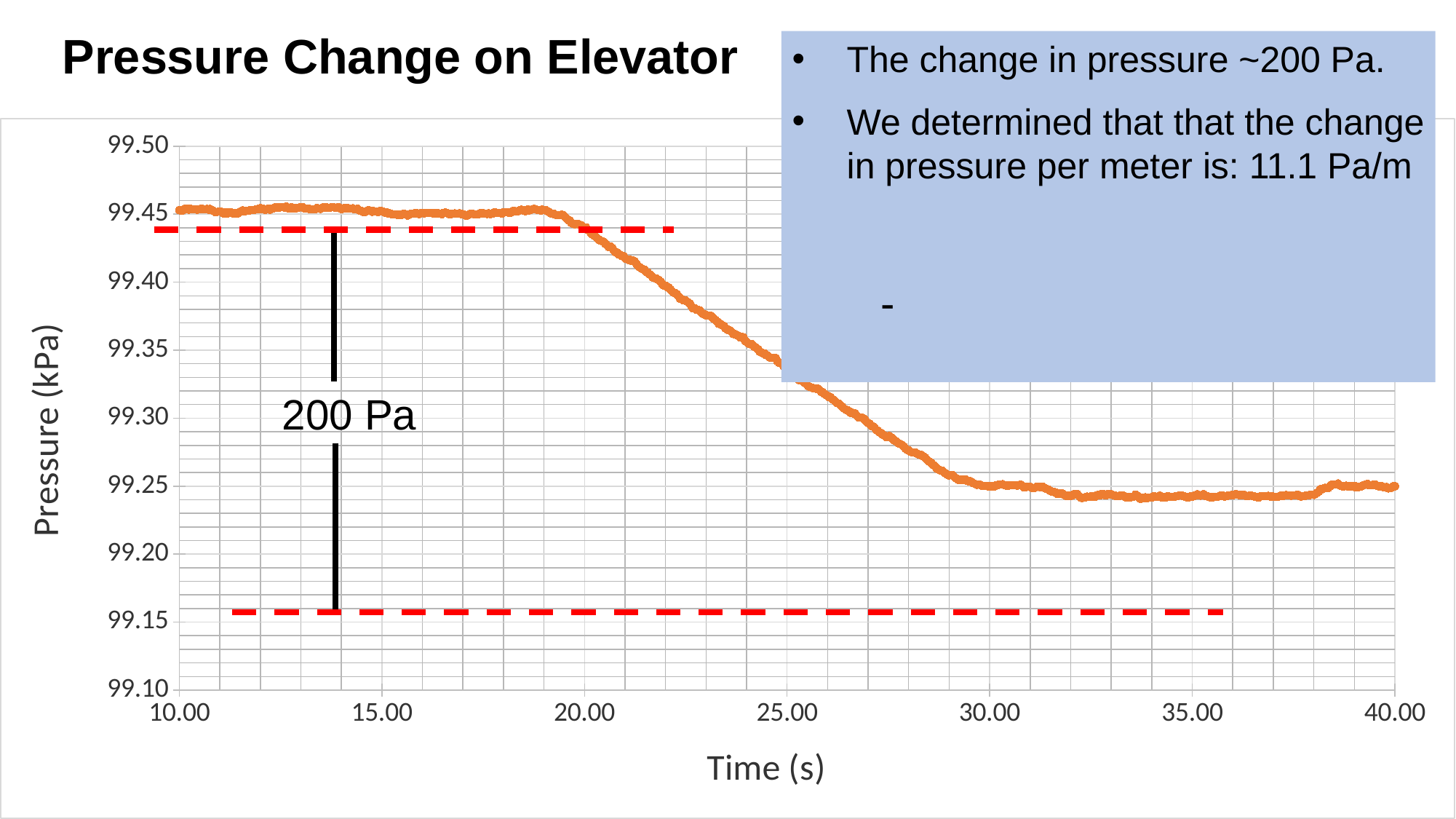
What pressure change is annotated between the two dashed red lines on the chart? 200 Pa Is the pressure at 35.00 s greater or less than 99.30 kPa? less Which is larger, the pressure at 12.00 s or the pressure at 32.00 s? the pressure at 12.00 s What is the label of the y axis? Pressure (kPa) Overall, does the pressure rise or fall as time increases from 10.00 s to 40.00 s? fall What is the highest value shown on the y axis? 99.50 Is the pressure at 25.00 s greater or less than 99.40 kPa? less Is the pressure at 15.00 s greater or less than 99.40 kPa? greater What kind of chart is shown on the slide? line chart What is the title of the chart? Pressure Change on Elevator